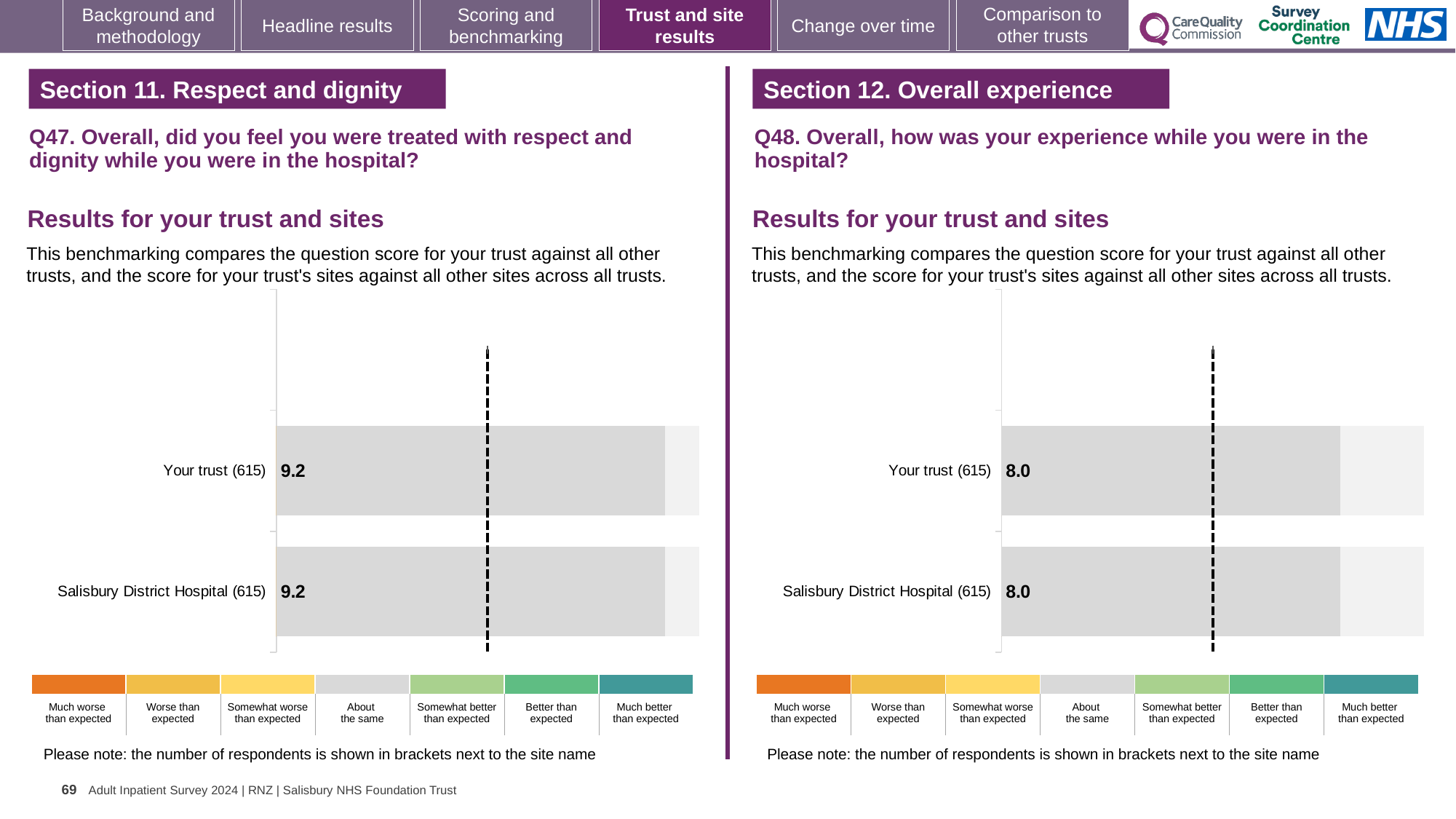
In the Q48 chart on the right, what is the difference between the score for Your trust and the score for Salisbury District Hospital? 0.0 In the Q47 chart on the left, what is the score for Salisbury District Hospital? 9.2 In the Q47 chart on the left, what is the score for Your trust? 9.2 How many bars are plotted in the Q47 chart on the left? 2 How many categories does the colour key below the Q48 chart on the right list? 7 In the Q47 chart on the left, what is the difference between the score for Your trust and the score for Salisbury District Hospital? 0.0 What kind of chart is used for the Q48 results on the right? Bar chart According to the colour key, which category does the grey colour of the bars in the Q47 chart on the left represent? About the same In the Q48 chart on the right, what is the score for Salisbury District Hospital? 8.0 In the Q48 chart on the right, what is the score for Your trust? 8.0 How many bars are plotted in the Q48 chart on the right? 2 In the Q47 chart on the left, how many respondents are shown in brackets next to Your trust? 615